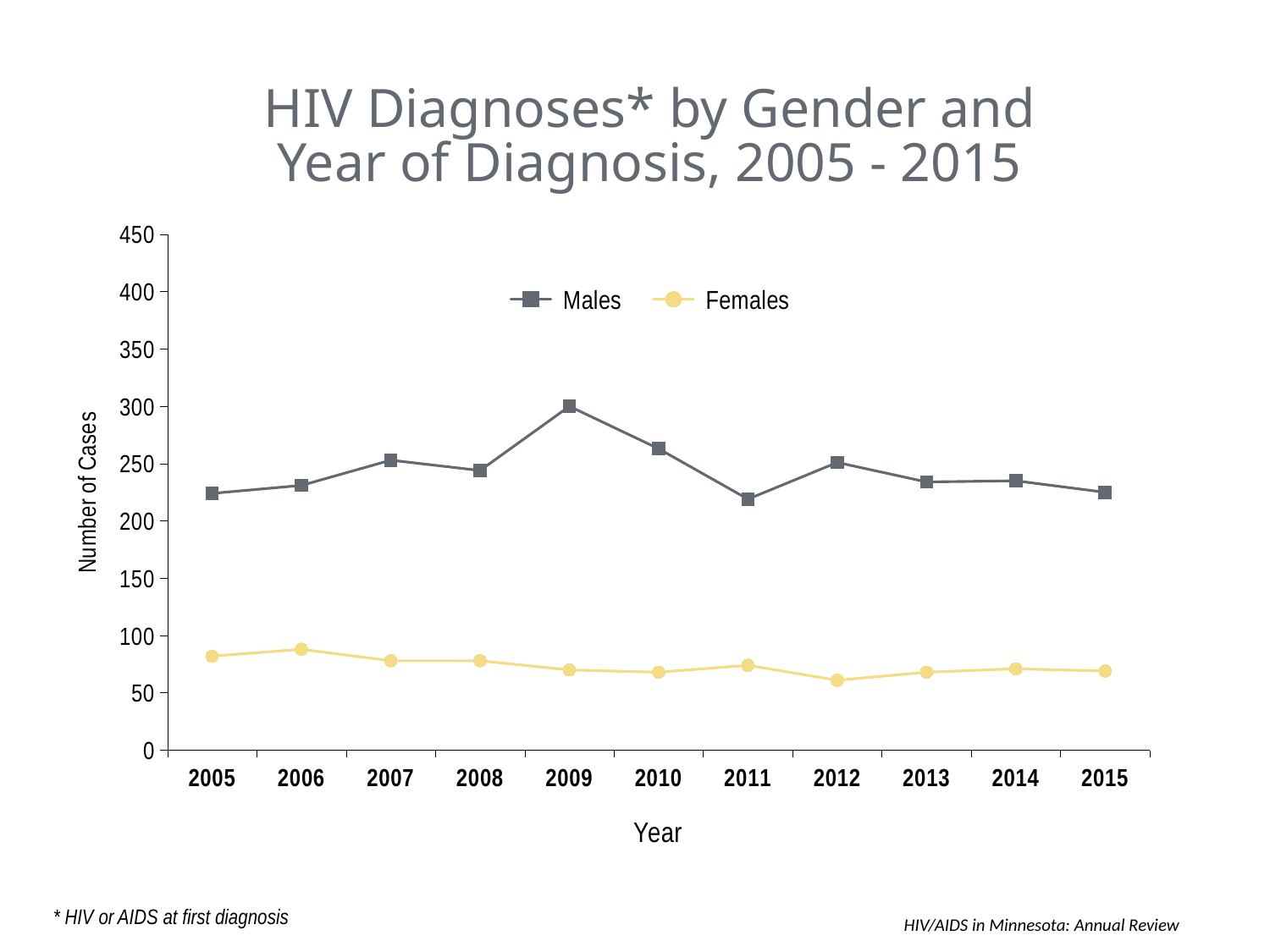
What kind of chart is shown on the slide? line chart In which year is the number of cases for Males highest? 2009 Is the value for Females in 2005 greater or less than 100? less Which series has the larger value in 2010, Males or Females? Males How many years are plotted along the x axis? 11 How many series does the legend list? 2 In which year is the number of cases for Females lowest? 2012 In which year is the number of cases for Females highest? 2006 Is the value for Males in 2009 greater or less than 250? greater Is the value for Males in 2011 greater or less than 200? greater What is the label on the y axis? Number of Cases In which year is the number of cases for Males lowest? 2011